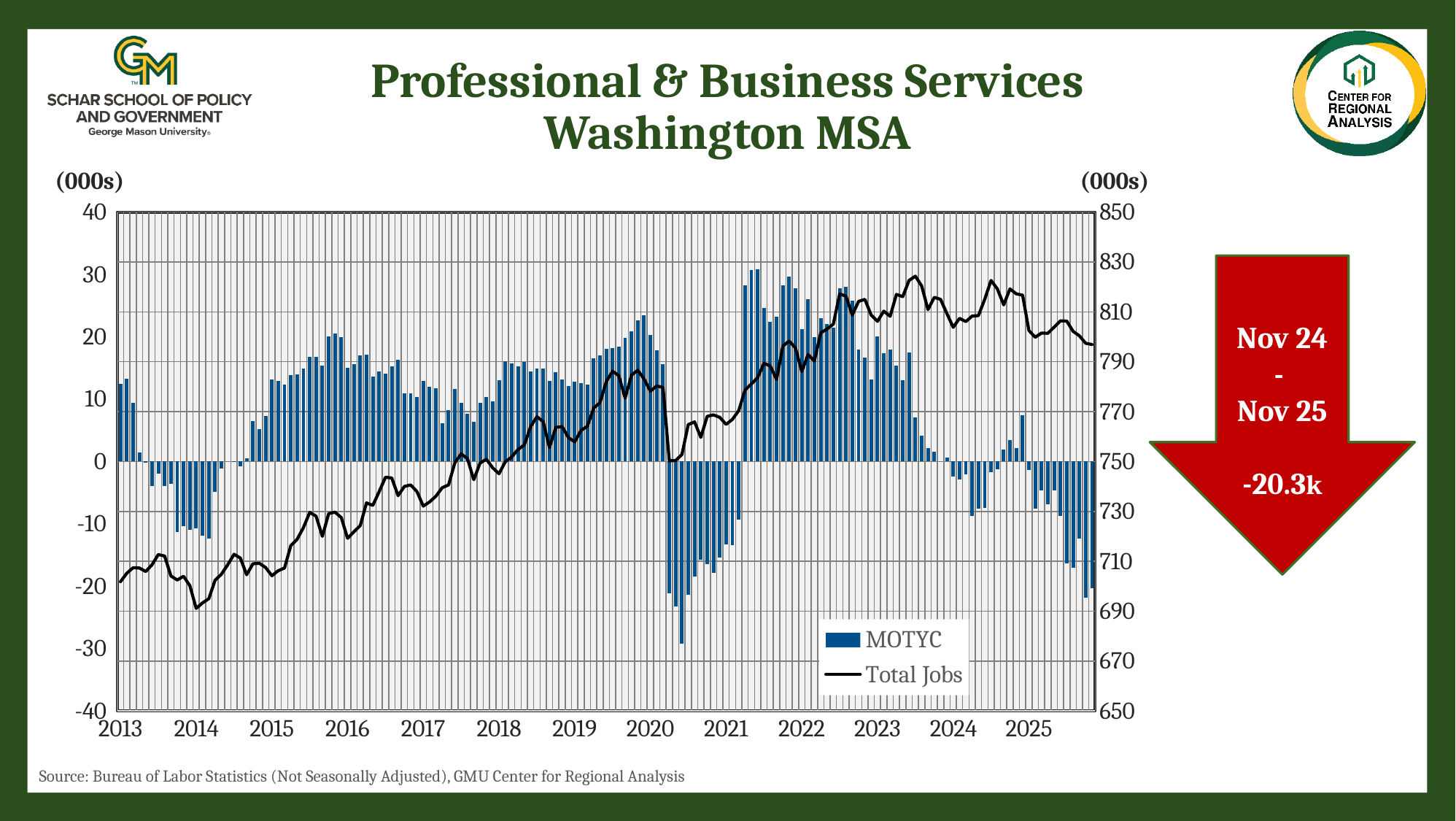
How many series does the chart legend list? 2 In which year does the MOTYC series reach its lowest bar? 2020 What is the title of the chart? Professional & Business Services Washington MSA Is the Total Jobs value at the start of 2013 greater or less than 730? less What is the change in jobs from Nov 24 to Nov 25 shown in the red arrow? -20.3k Is the Total Jobs value at the end of 2025 greater or less than 810? less Is the lowest MOTYC bar in 2020 greater or less than -20? less In which year does the MOTYC series reach its highest bar? 2021 Does the Total Jobs line rise or fall from 2013 to 2023 overall? rise What kind of chart is shown on the slide? Combined bar and line chart What are the two series named in the legend? MOTYC and Total Jobs